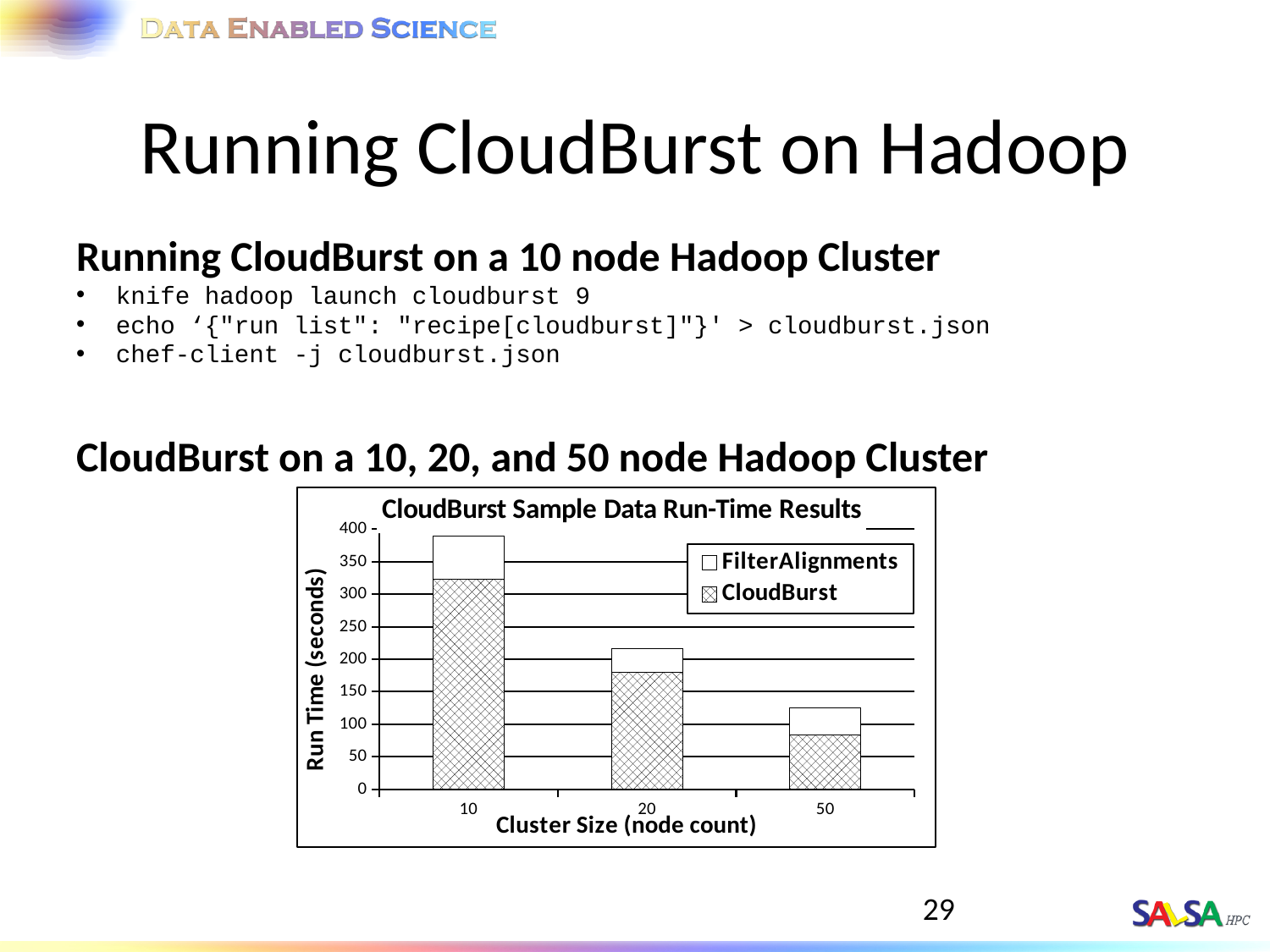
What kind of chart is shown on the slide? stacked bar chart How many cluster sizes are plotted on the x axis? 3 What is the title of the chart? CloudBurst Sample Data Run-Time Results What is the label of the y axis? Run Time (seconds) How many series does the chart legend list? 2 Which cluster size has the lowest total run time? 50 Does the total run time rise or fall as the cluster size increases along the x axis? fall Is the total run time for the 50 node cluster greater or less than 100 seconds? greater Which cluster size has the highest total run time? 10 Is the CloudBurst run time for the 20 node cluster greater or less than 200 seconds? less Is the total run time for the 10 node cluster greater or less than 350 seconds? greater Which is larger, the CloudBurst run time for the 20 node cluster or for the 50 node cluster? 20 node cluster